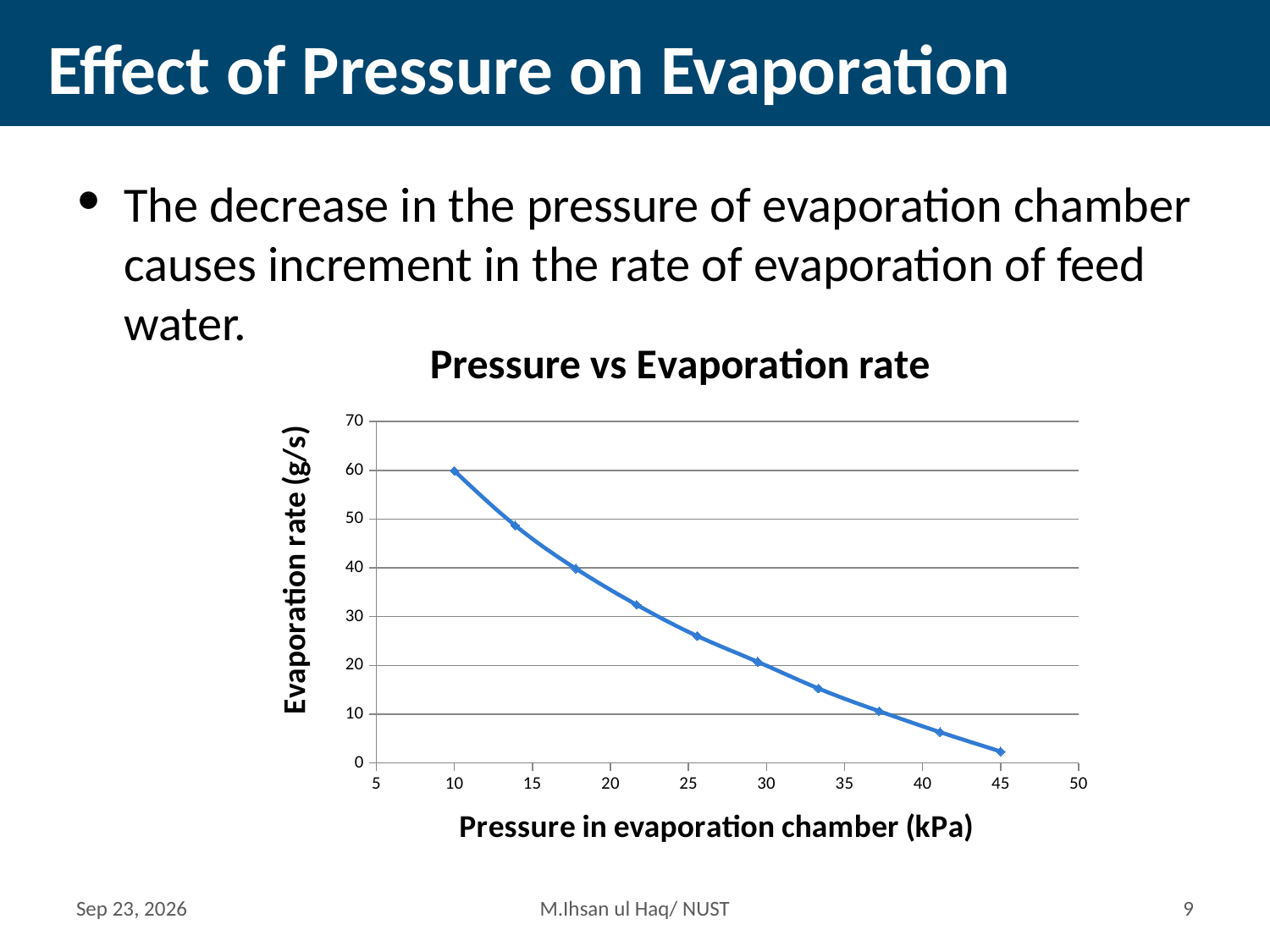
What is the label of the y axis? Evaporation rate (g/s) Which is larger, the evaporation rate at 10 kPa or at 45 kPa? 10 kPa What is the title of the chart? Pressure vs Evaporation rate How many data points are plotted on the chart? 10 What kind of chart is shown on the slide? line chart At which pressure is the evaporation rate lowest? 45 kPa Is the evaporation rate at 45 kPa greater or less than 10? less Does the evaporation rate rise or fall as pressure increases along the x axis? fall At which pressure is the evaporation rate highest? 10 kPa Is the evaporation rate at about 14 kPa greater or less than 50? less Is the evaporation rate at about 25 kPa greater or less than 20? greater